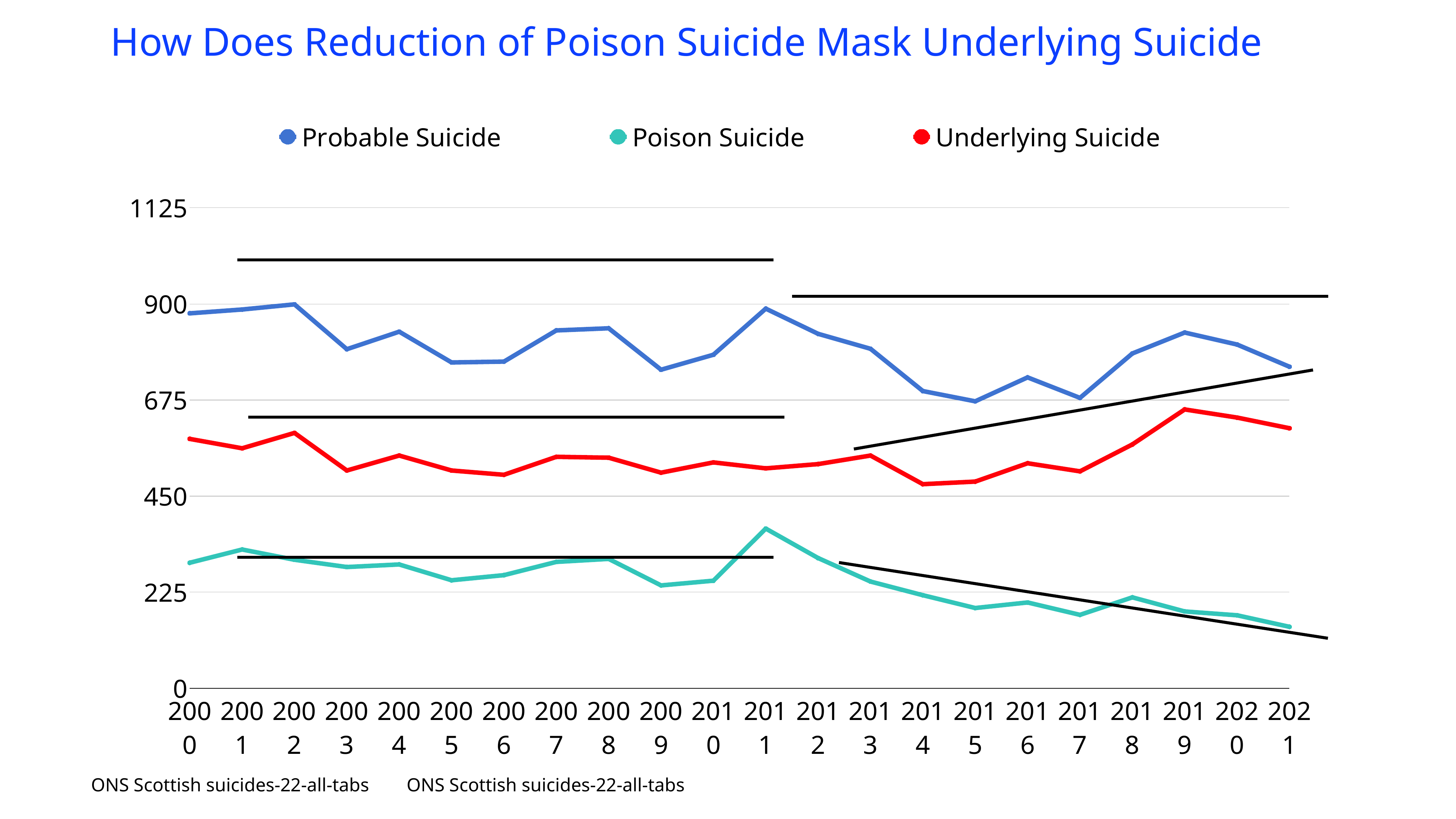
How many years are plotted along the x axis? 22 How many series does the legend list? 3 Does the Poison Suicide line rise or fall from 2011 to 2021? fall Is the value for Probable Suicide in 2015 greater or less than 900? less Is the value for Probable Suicide in 2002 greater or less than 675? greater Is the value for Underlying Suicide in 2014 greater or less than 675? less In which year does Poison Suicide reach its highest value? 2011 In 2011, which series has the larger value, Probable Suicide or Poison Suicide? Probable Suicide What kind of chart is shown on the slide? line chart In which year does Underlying Suicide reach its highest value? 2019